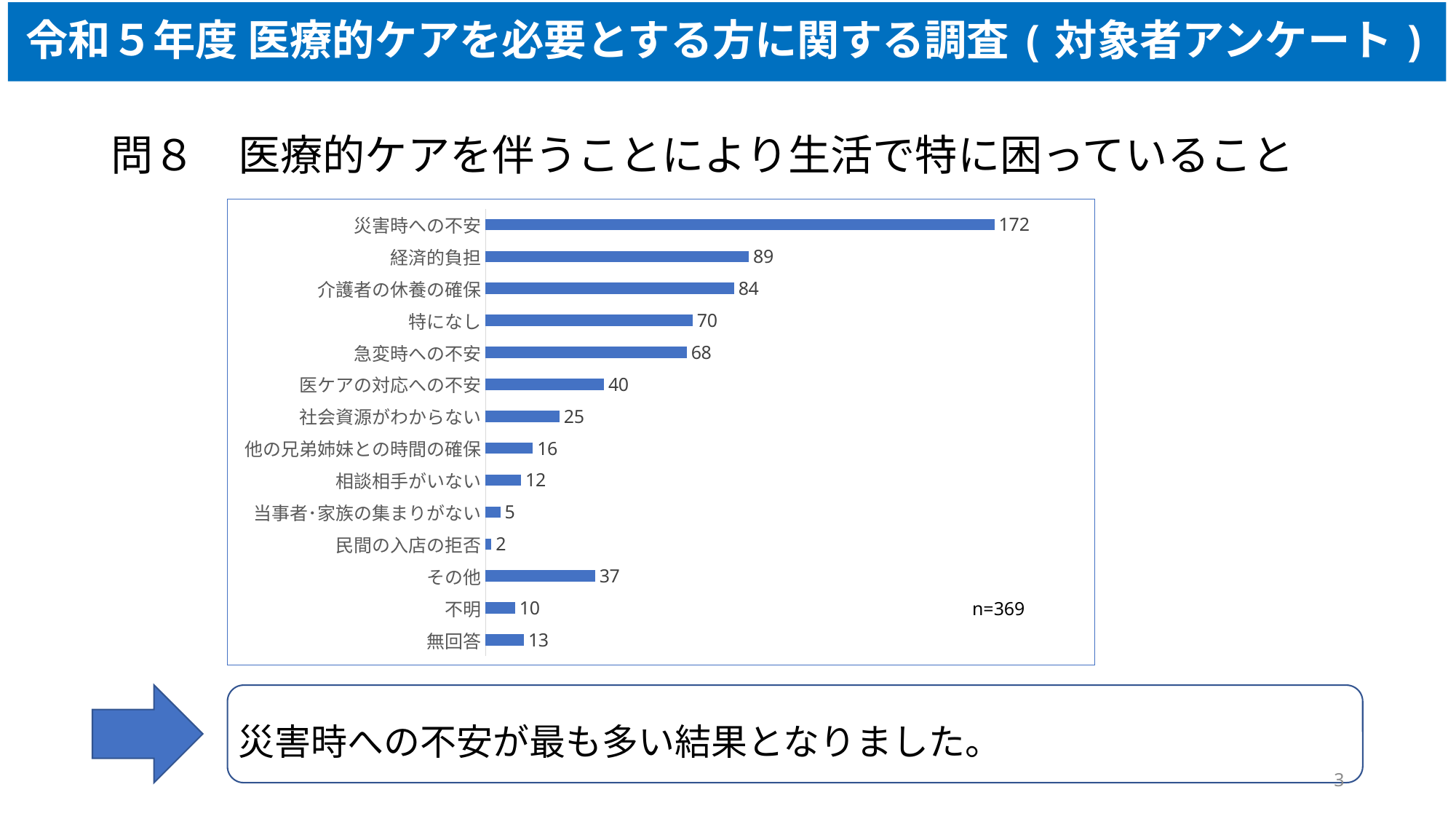
What is the value for 介護者の休養の確保? 84 How many categories are shown in the chart? 14 Which category has the lowest value? 民間の入店の拒否 Which category has the highest value? 災害時への不安 What sample size (n) is shown on the chart? n=369 What is the value for その他? 37 What is the value for 災害時への不安? 172 What kind of chart is shown on the slide? Bar chart What is the difference between the values for 災害時への不安 and 経済的負担? 83 What is the difference between the values for 特になし and 急変時への不安? 2 What is the value for 無回答? 13 Which is larger, the value for 医ケアの対応への不安 or the value for 社会資源がわからない? 医ケアの対応への不安